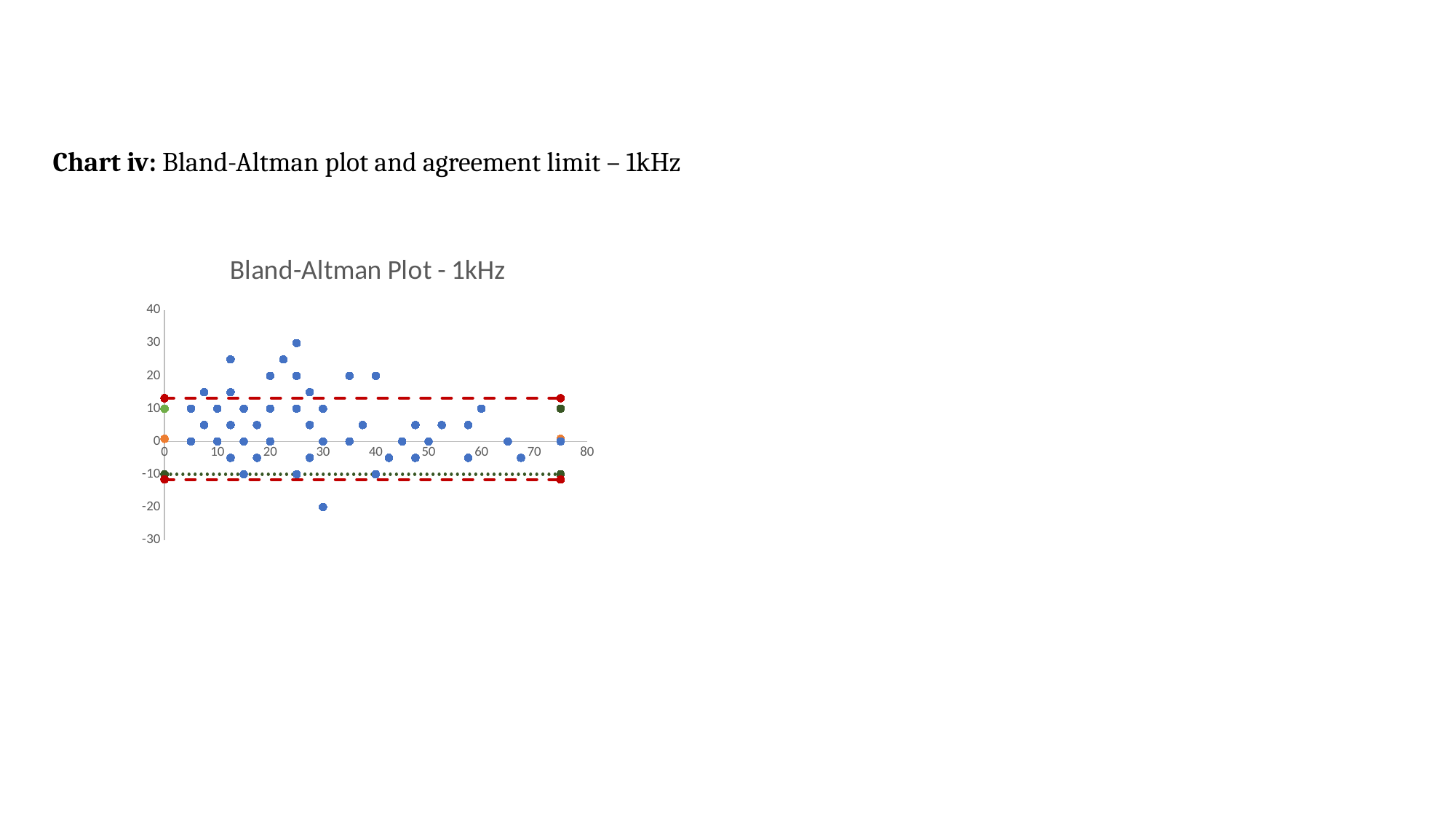
Is the lowest blue point on the chart greater or less than -10? less What is the highest value labelled on the vertical axis? 40 Is the upper red dashed line greater or less than 10 on the vertical axis? greater How many tick labels are shown on the horizontal axis? 9 What is the lowest value labelled on the vertical axis? -30 What is the highest value labelled on the horizontal axis? 80 Is the green dotted line greater or less than 0 on the vertical axis? less What kind of chart is shown on the slide? scatter chart What is the title of the chart? Bland-Altman Plot - 1kHz Which is higher on the chart, the upper red dashed line or the green dotted line? the upper red dashed line